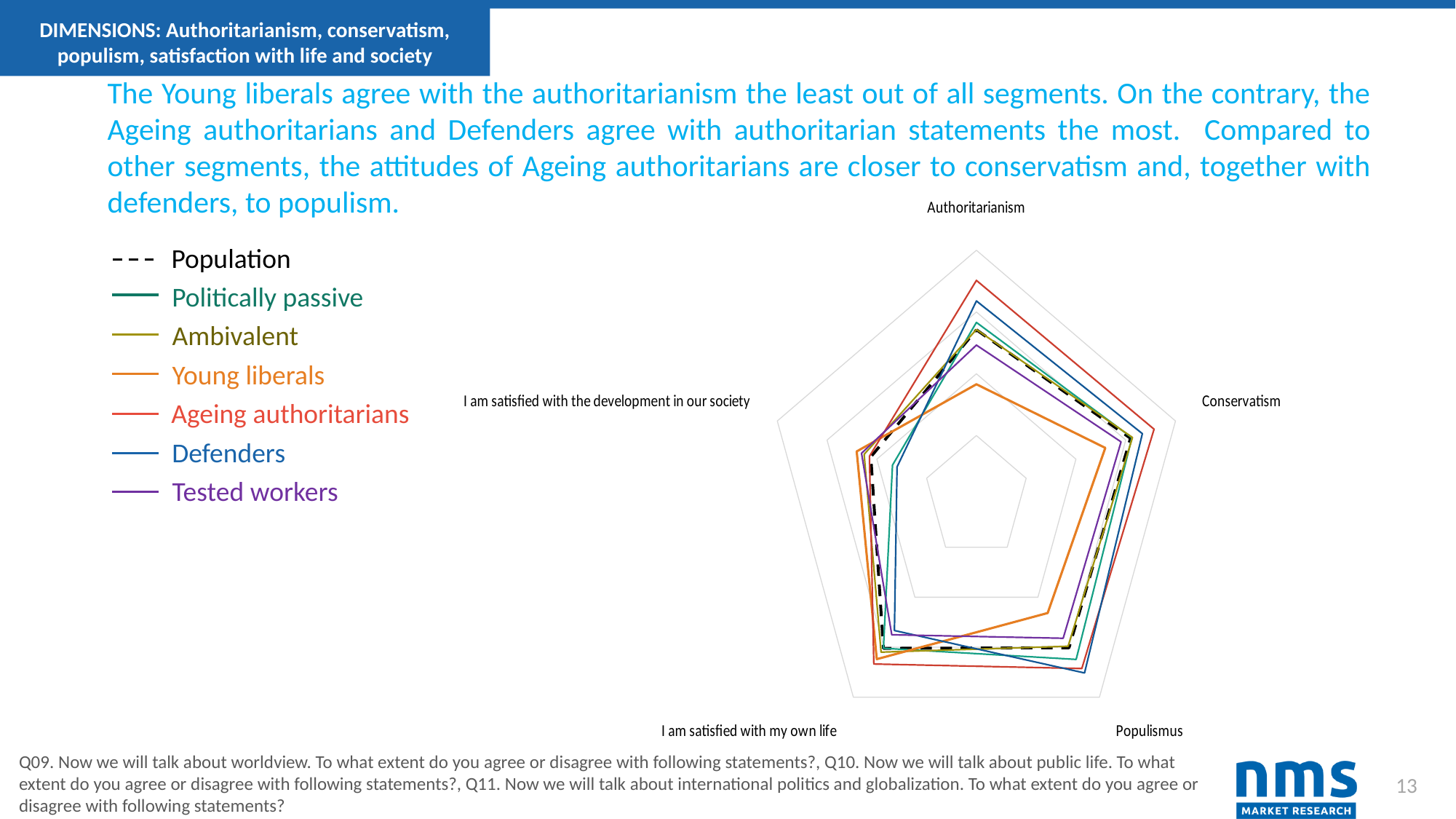
Which segment has the highest value on the Conservatism axis? Ageing authoritarians How many dimensions (axes) does the radar chart have? 5 On the Conservatism axis, which is larger: Defenders or Tested workers? Defenders Which segment has the lowest value on the Populismus axis? Young liberals Which segment has the lowest value on the Authoritarianism axis? Young liberals What colour is the line for Young liberals? Orange Which segment has the lowest value on the Conservatism axis? Young liberals Which segment has the highest value on the Authoritarianism axis? Ageing authoritarians What kind of chart is shown on the slide? Radar chart Which series is drawn with a dashed line in the chart? Population How many series does the legend list? 7